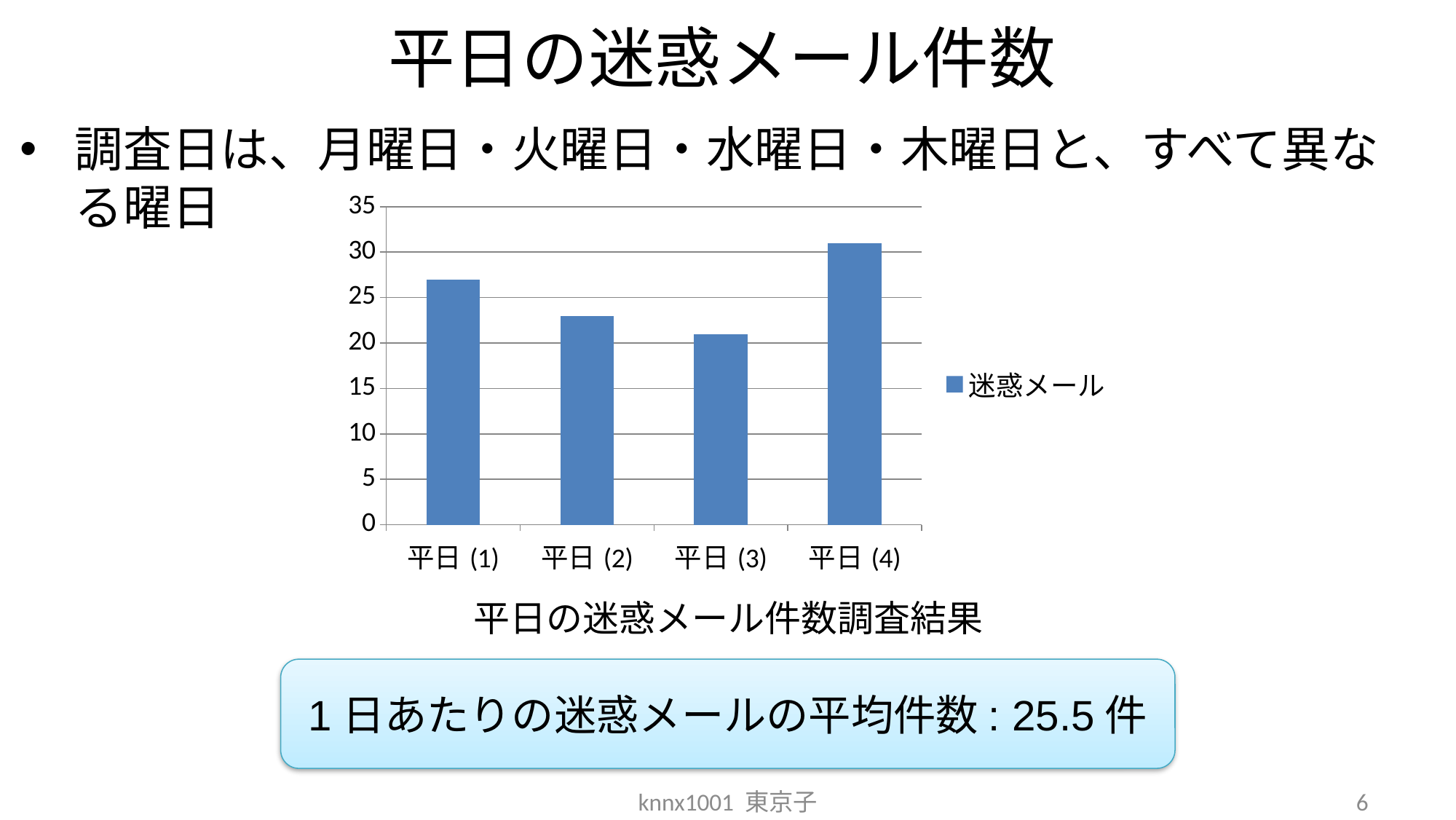
How many series does the chart's legend list? 1 Is the value for 平日 (4) greater or less than 25? greater How many categories (bars) does the chart show? 4 Is the value for 平日 (1) greater or less than 25? greater Which category has the lowest value in the chart? 平日 (3) Which is larger, the value for 平日 (4) or the value for 平日 (1)? 平日 (4) What is the name of the series shown in the chart's legend? 迷惑メール What kind of chart is shown on the slide? bar chart Is the value for 平日 (3) greater or less than 25? less Which category has the highest value in the chart? 平日 (4) Which is larger, the value for 平日 (1) or the value for 平日 (2)? 平日 (1)